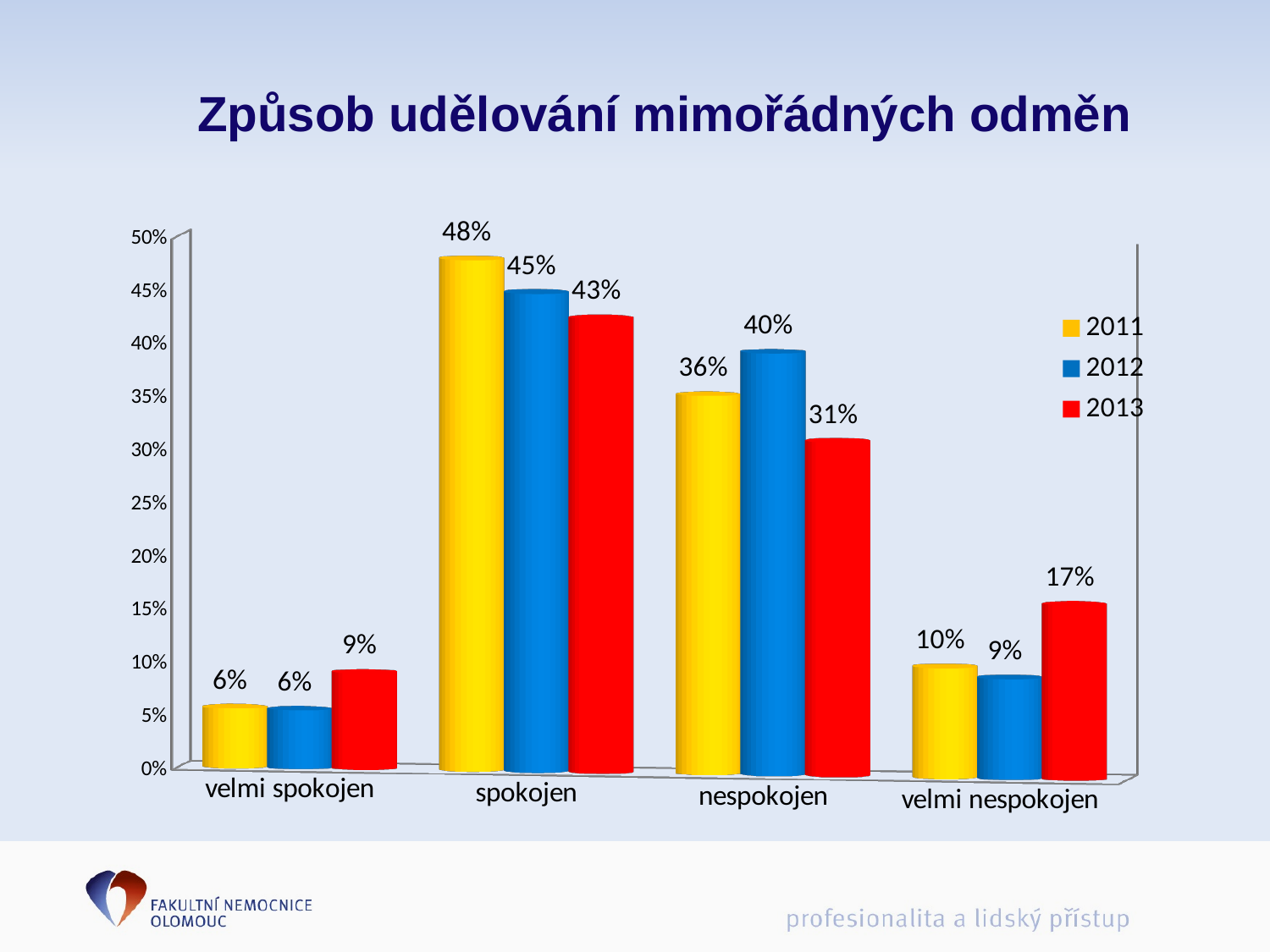
What kind of chart is shown on the slide? bar chart Which category has the highest value in 2013? spokojen Is the value for 'spokojen' in 2012 greater or less than 40%? greater What is the value for 'nespokojen' in 2012? 40% What is the difference between the 2011 and 2013 values for 'nespokojen'? 5% What is the value for 'spokojen' in 2011? 48% How many categories are shown on the x axis? 4 Which category has the lowest value in 2012? velmi spokojen What is the value for 'velmi nespokojen' in 2013? 17% How many series does the legend list? 3 What is the title of the chart? Způsob udělování mimořádných odměn Which is larger for 'velmi nespokojen': the 2011 value or the 2013 value? 2013